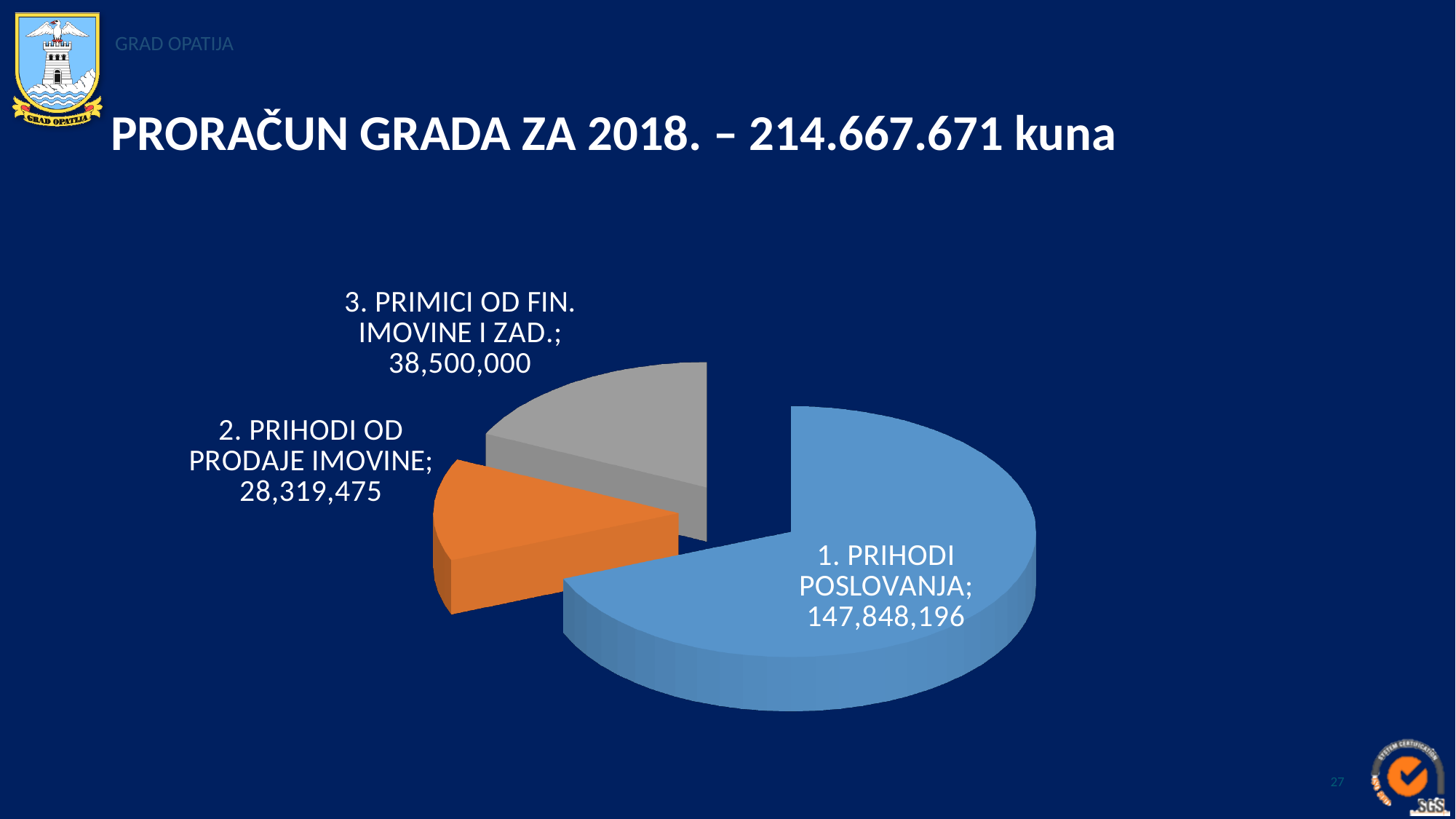
What type of chart is shown on the slide? Pie chart How many slices does the pie chart have? 3 What is the difference between 3. PRIMICI OD FIN. IMOVINE I ZAD. and 2. PRIHODI OD PRODAJE IMOVINE? 10,180,525 What is the value for 3. PRIMICI OD FIN. IMOVINE I ZAD.? 38,500,000 What colour is the slice for 1. PRIHODI POSLOVANJA? Blue What is the value for 2. PRIHODI OD PRODAJE IMOVINE? 28,319,475 Which category has the smallest slice of the pie? 2. PRIHODI OD PRODAJE IMOVINE Which is larger: 2. PRIHODI OD PRODAJE IMOVINE or 3. PRIMICI OD FIN. IMOVINE I ZAD.? 3. PRIMICI OD FIN. IMOVINE I ZAD. Which category has the largest slice of the pie? 1. PRIHODI POSLOVANJA What is the total of all three slices in the pie chart? 214,667,671 What is the value for 1. PRIHODI POSLOVANJA? 147,848,196 What is the difference between 1. PRIHODI POSLOVANJA and 3. PRIMICI OD FIN. IMOVINE I ZAD.? 109,348,196